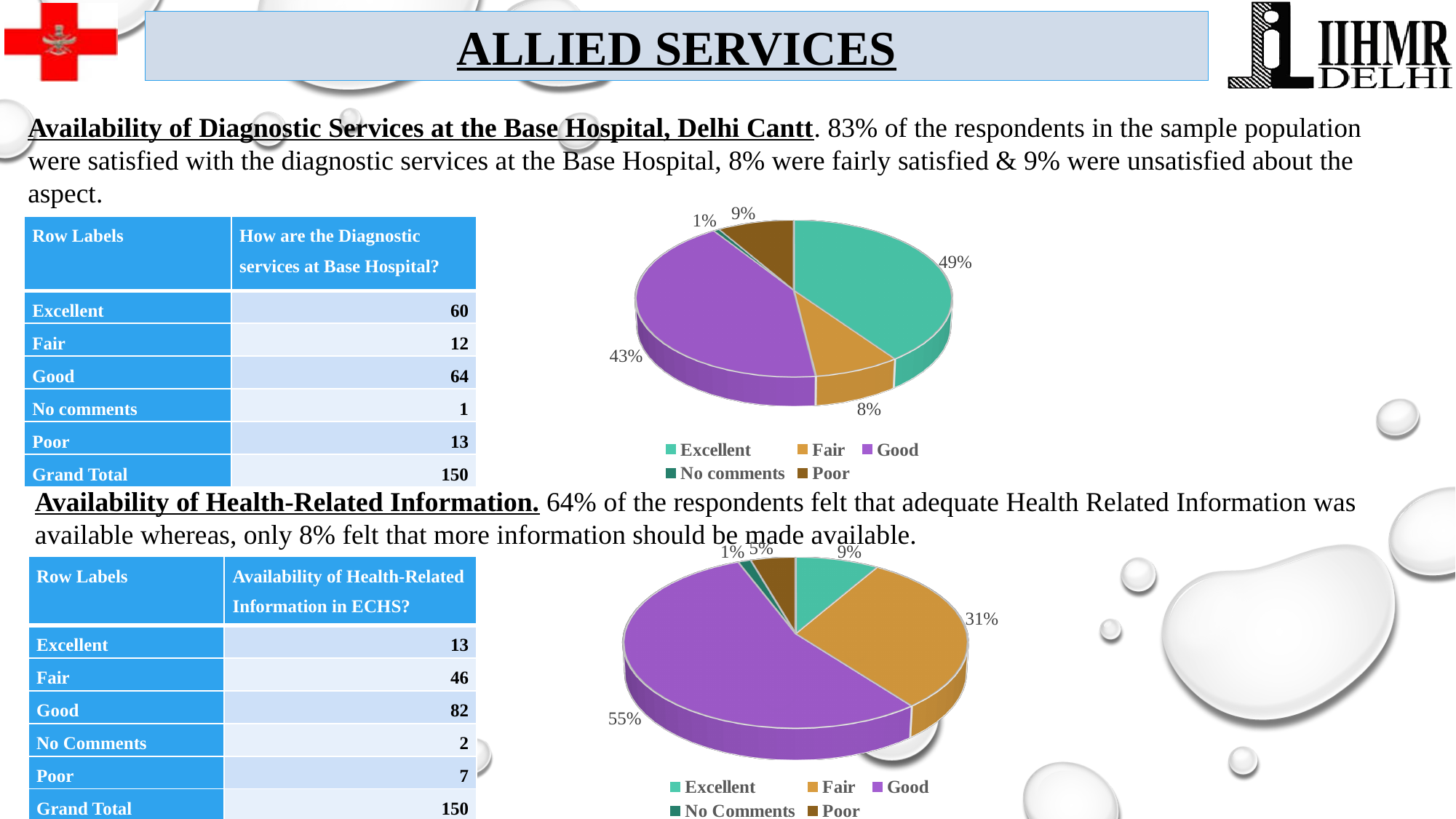
In the top pie chart (diagnostic services at Base Hospital), what percentage is shown for the Good slice? 43% In the bottom pie chart (health-related information in ECHS), which slice is larger, Poor or Excellent? Excellent In the top pie chart (diagnostic services at Base Hospital), what percentage is shown for the Fair slice? 8% In the bottom pie chart (health-related information in ECHS), what percentage is shown for the Fair slice? 31% In the top pie chart (diagnostic services at Base Hospital), which category has the smallest slice? No comments In the top pie chart (diagnostic services at Base Hospital), what percentage is shown for the Poor slice? 9% In the bottom pie chart (health-related information in ECHS), which category has the largest slice? Good In the bottom pie chart (health-related information in ECHS), what percentage is shown for the Good slice? 55% What type of chart is used in the top chart about diagnostic services at Base Hospital? pie chart In the bottom pie chart (health-related information in ECHS), what percentage is shown for the Excellent slice? 9% In the bottom pie chart (health-related information in ECHS), what is the difference in percentage points between the Good and Fair slices? 24 How many categories does the legend of the top pie chart (diagnostic services at Base Hospital) list? 5